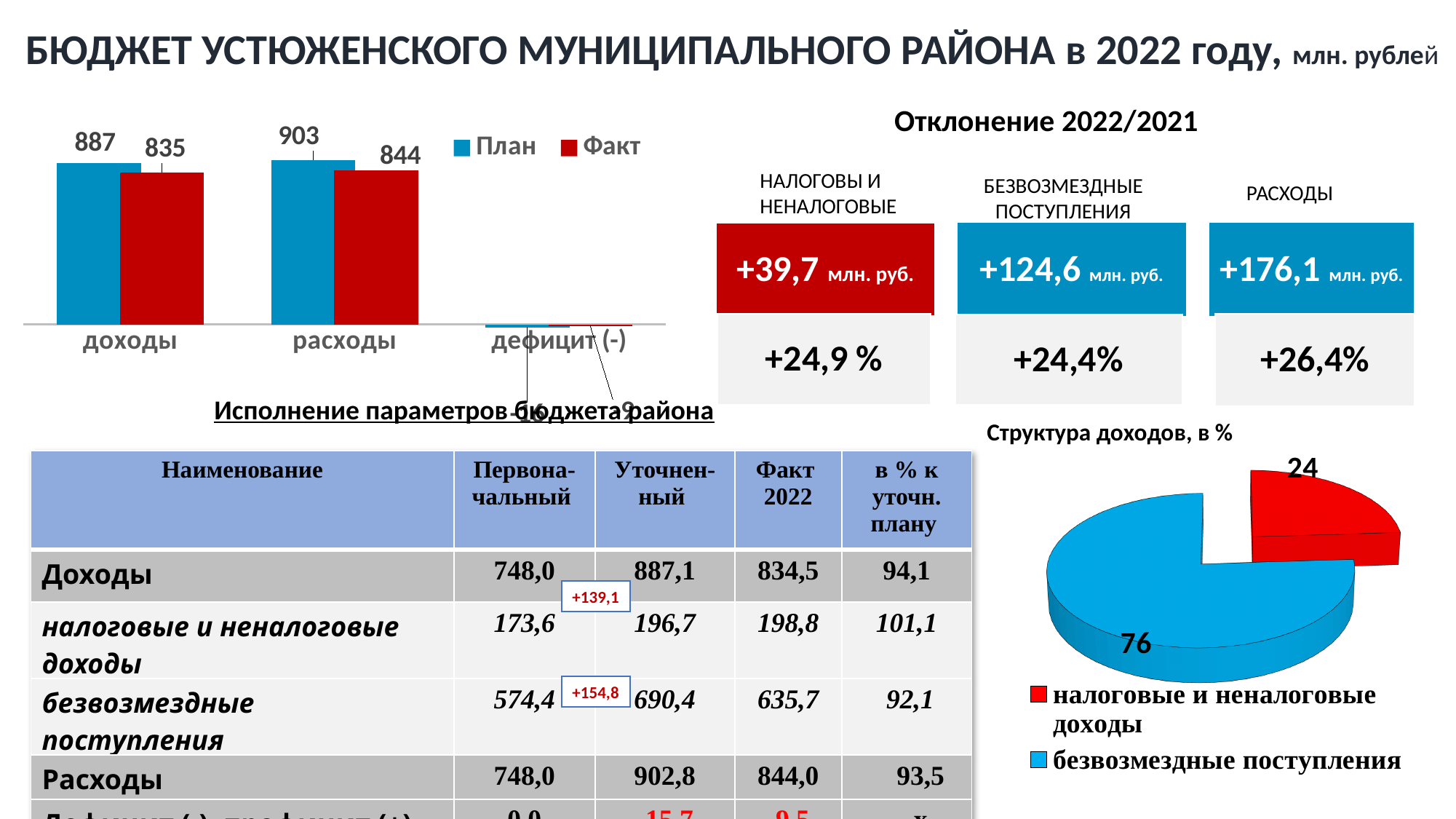
In the bar chart on the left, what is the Факт value for расходы? 844 In the bar chart on the left, what is the Факт value for доходы? 835 In the pie chart 'Структура доходов, в %', which slice is the largest? безвозмездные поступления In the bar chart on the left, how many series does the legend list? 2 What kind of chart is shown at the top left of the slide? bar chart In the bar chart on the left, what is the План value for доходы? 887 In the pie chart 'Структура доходов, в %', what share do налоговые и неналоговые доходы have? 24 In the pie chart 'Структура доходов, в %', what colour is the slice for налоговые и неналоговые доходы? red In the bar chart on the left, how many categories are shown on the x axis? 3 In the pie chart 'Структура доходов, в %', what share do безвозмездные поступления have? 76 In the bar chart on the left, which is larger for доходы: План or Факт? План In the bar chart on the left, what is the difference between the План and Факт values for расходы? 59